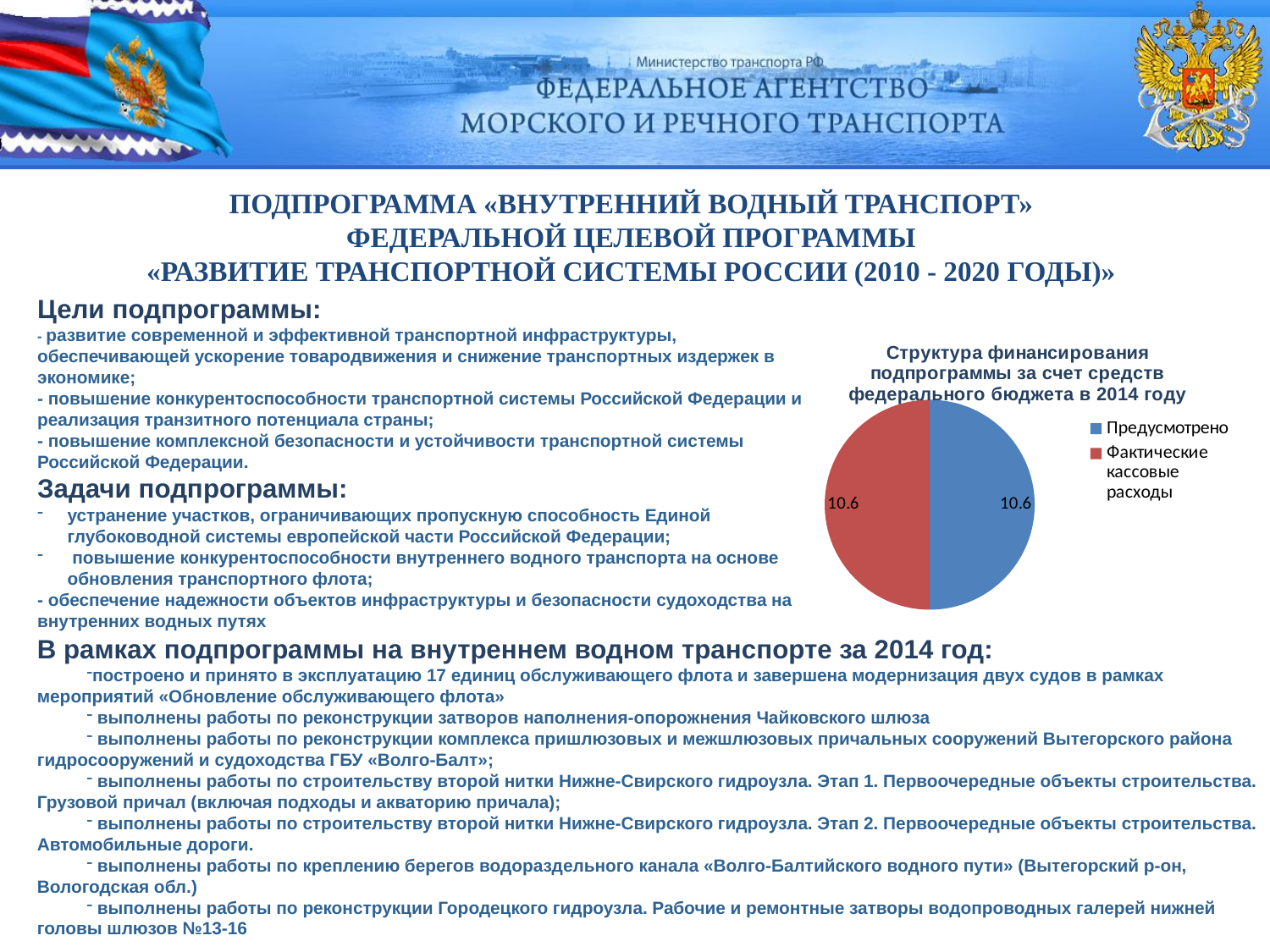
How many slices does the pie chart have? 2 What kind of chart is shown on the slide? pie chart What is the difference between the values for "Предусмотрено" and "Фактические кассовые расходы"? 0 What share of the pie does the "Фактические кассовые расходы" slice represent? 50% How many entries does the chart legend list? 2 What is the total of the two slice values in the pie chart? 21.2 What value is shown for the slice "Фактические кассовые расходы"? 10.6 Which colour represents "Фактические кассовые расходы" in the pie chart? red What value is shown for the slice "Предусмотрено"? 10.6 What share of the pie does the "Предусмотрено" slice represent? 50% What is the title of the chart on the slide? Структура финансирования подпрограммы за счет средств федерального бюджета в 2014 году